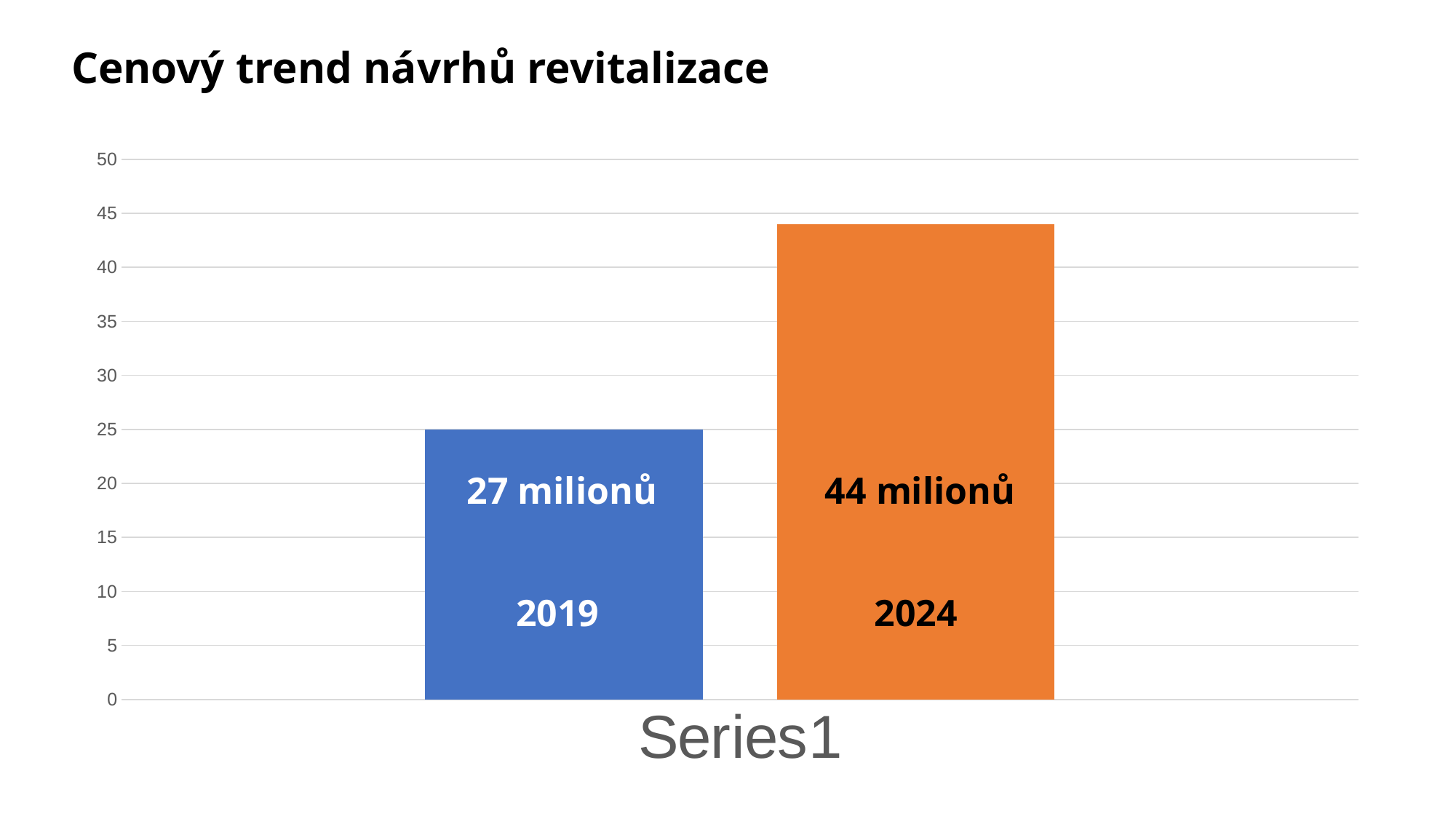
What value is shown for 2024? 44 milionů What is the title of the chart? Cenový trend návrhů revitalizace Is the bar for 2024 greater or less than 40 on the axis? greater Is the bar for 2019 greater or less than 30 on the axis? less What value is shown for 2019? 27 milionů Which year has the lower value? 2019 Which year has the higher value? 2024 Do the values rise or fall from 2019 to 2024? rise How many bars are plotted in the chart? 2 Is the value for 2024 larger or smaller than the value for 2019? larger What kind of chart is shown on the slide? bar chart